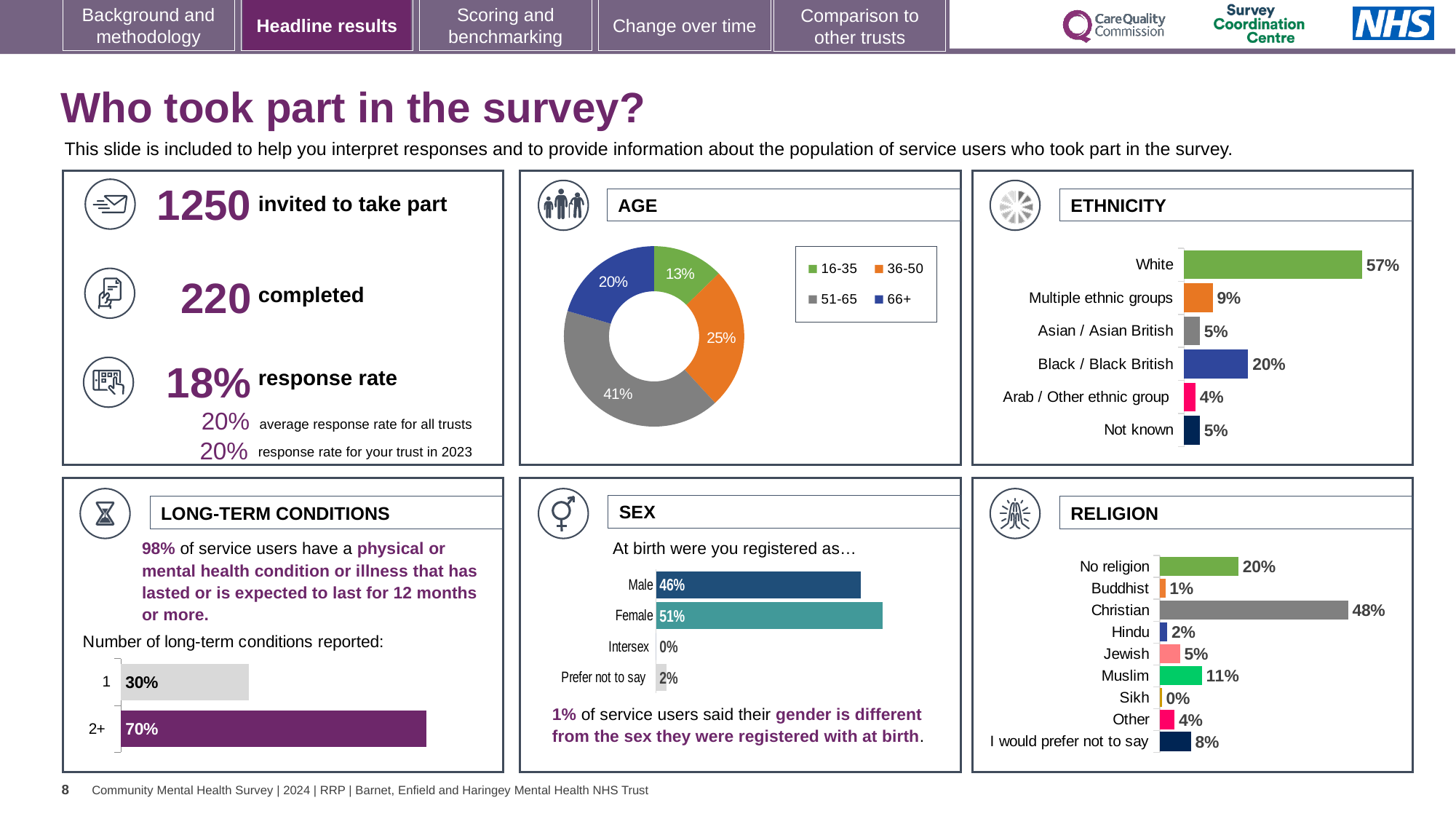
What kind of chart is the AGE chart? Donut chart In the AGE chart, what percentage of respondents were aged 51-65? 41% In the SEX chart, what is the value for Prefer not to say? 2% In the AGE chart, which age group has the smallest share? 16-35 In the LONG-TERM CONDITIONS chart, what percentage reported 2+ long-term conditions? 70% In the SEX chart, which is larger, Male or Female? Female How many entries does the legend of the AGE chart list? 4 In the ETHNICITY chart, which category has the highest value? White How many categories are shown in the ETHNICITY chart? 6 In the RELIGION chart, which religion has the highest value? Christian In the ETHNICITY chart, what is the difference between White and Multiple ethnic groups? 48% In the ETHNICITY chart, what is the value for Black / Black British? 20%